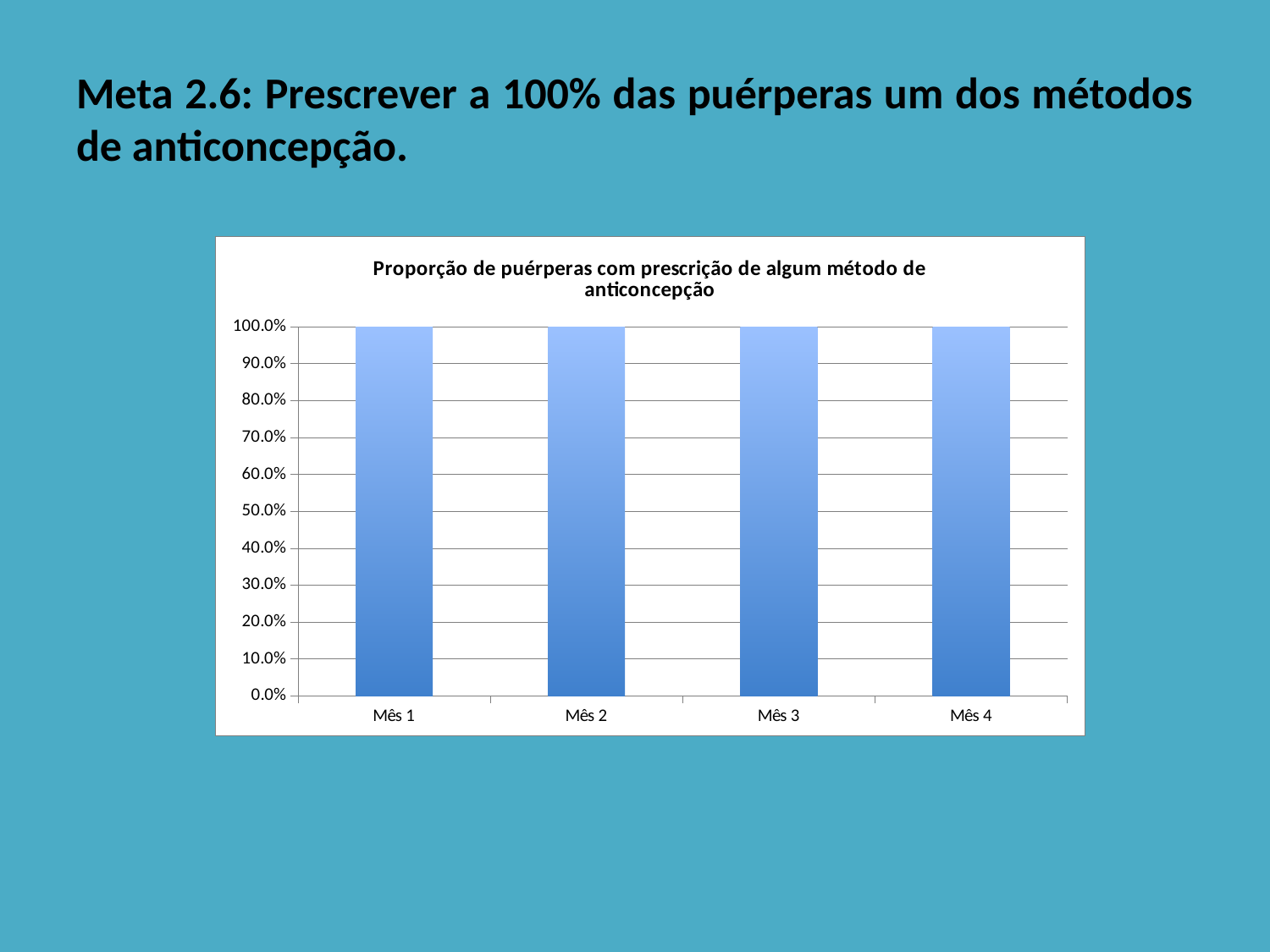
What type of chart is shown on the slide? bar chart What is the title of the chart? Proporção de puérperas com prescrição de algum método de anticoncepção What is the value for Mês 3 in the chart? 100.0% What is the difference between the values for Mês 1 and Mês 4? 0.0% Is the value for Mês 4 greater or less than 90.0%? greater What is the value for Mês 2 in the chart? 100.0% What is the value for Mês 1 in the chart? 100.0% What is the highest value shown on the y axis of the chart? 100.0% Do the values rise, fall, or stay the same from Mês 1 to Mês 4? stay the same Is the value for Mês 2 greater or less than 50.0%? greater How many categories (months) are shown on the x axis of the chart? 4 What is the value for Mês 4 in the chart? 100.0%